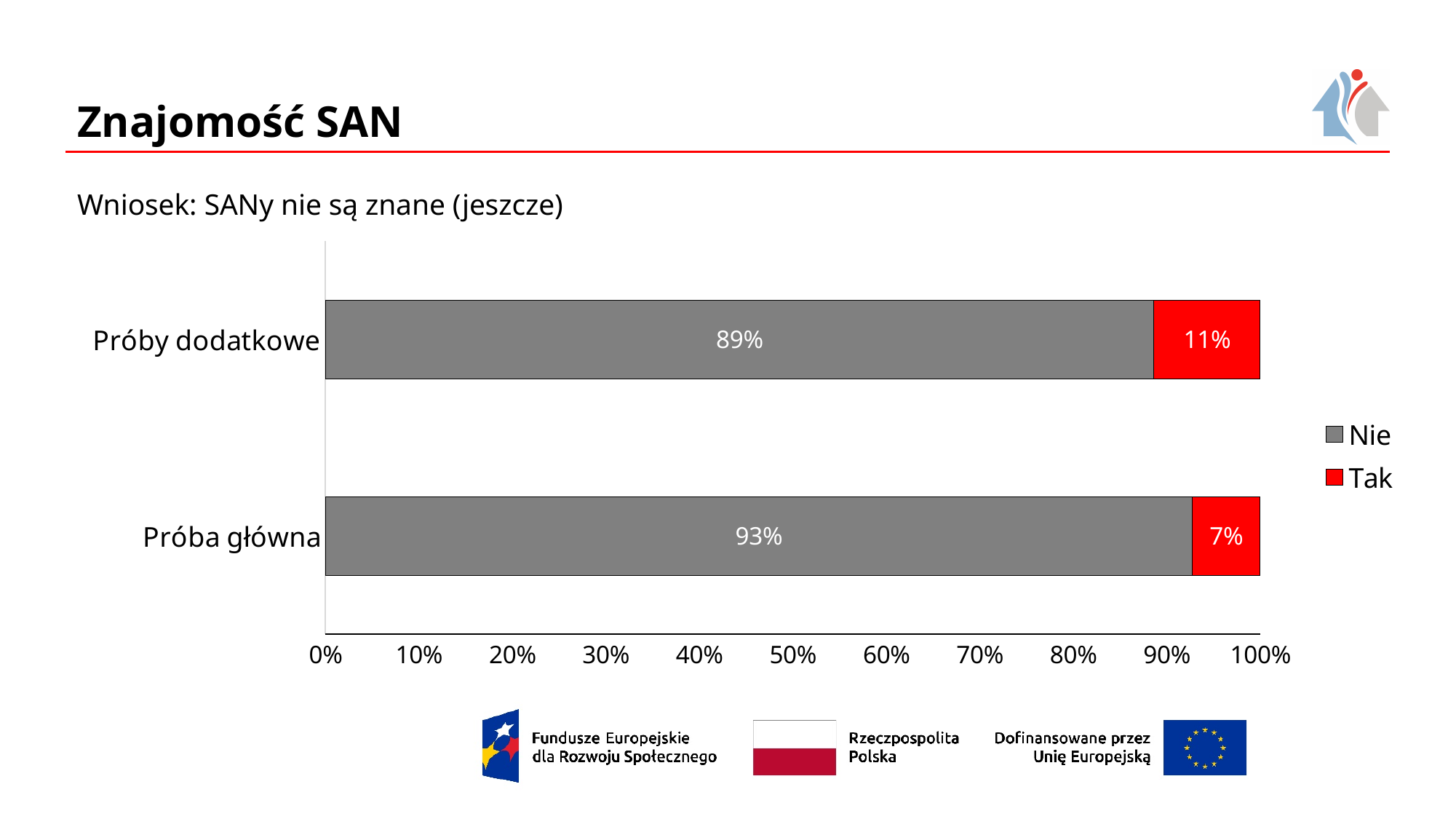
How many series does the legend list? 2 Which category has the lower Nie value? Próby dodatkowe Which colour represents the Tak series in the legend? red What kind of chart is shown on the slide? stacked bar chart Which category has the higher Tak value? Próby dodatkowe What is the value for Nie in the Próby dodatkowe bar? 89% What is the value for Tak in the Próba główna bar? 7% Is the Nie value for Próba główna larger or smaller than the Nie value for Próby dodatkowe? larger What is the value for Nie in the Próba główna bar? 93% How many categories are shown on the chart? 2 What is the value for Tak in the Próby dodatkowe bar? 11% What is the difference between the Tak values for Próby dodatkowe and Próba główna? 4%